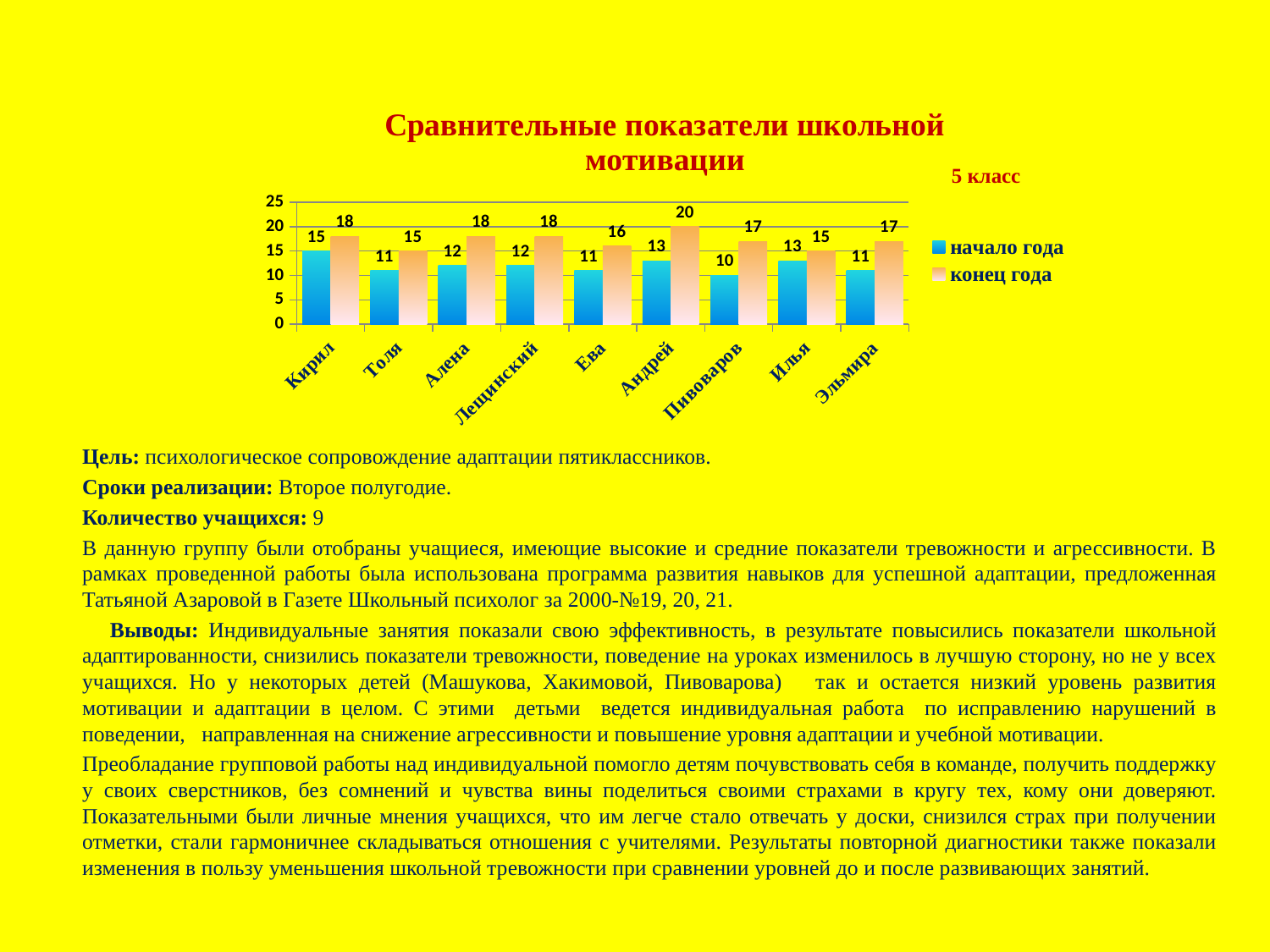
Which is larger: the конец года value for Толя or the конец года value for Эльмира? Эльмира What is the difference between the конец года and начало года values for Кирил? 3 Which category has the lowest value in the начало года series? Пивоваров What is the difference between the конец года and начало года values for Пивоваров? 7 What kind of chart is shown on the slide? bar chart How many series does the legend list? 2 Which category has the highest value in the конец года series? Андрей Which category has the highest value in the начало года series? Кирил How many categories (students) are shown on the x axis? 9 What is the value for Пивоваров in the начало года series? 10 What is the value for Ева in the конец года series? 16 What is the value for Андрей in the конец года series? 20